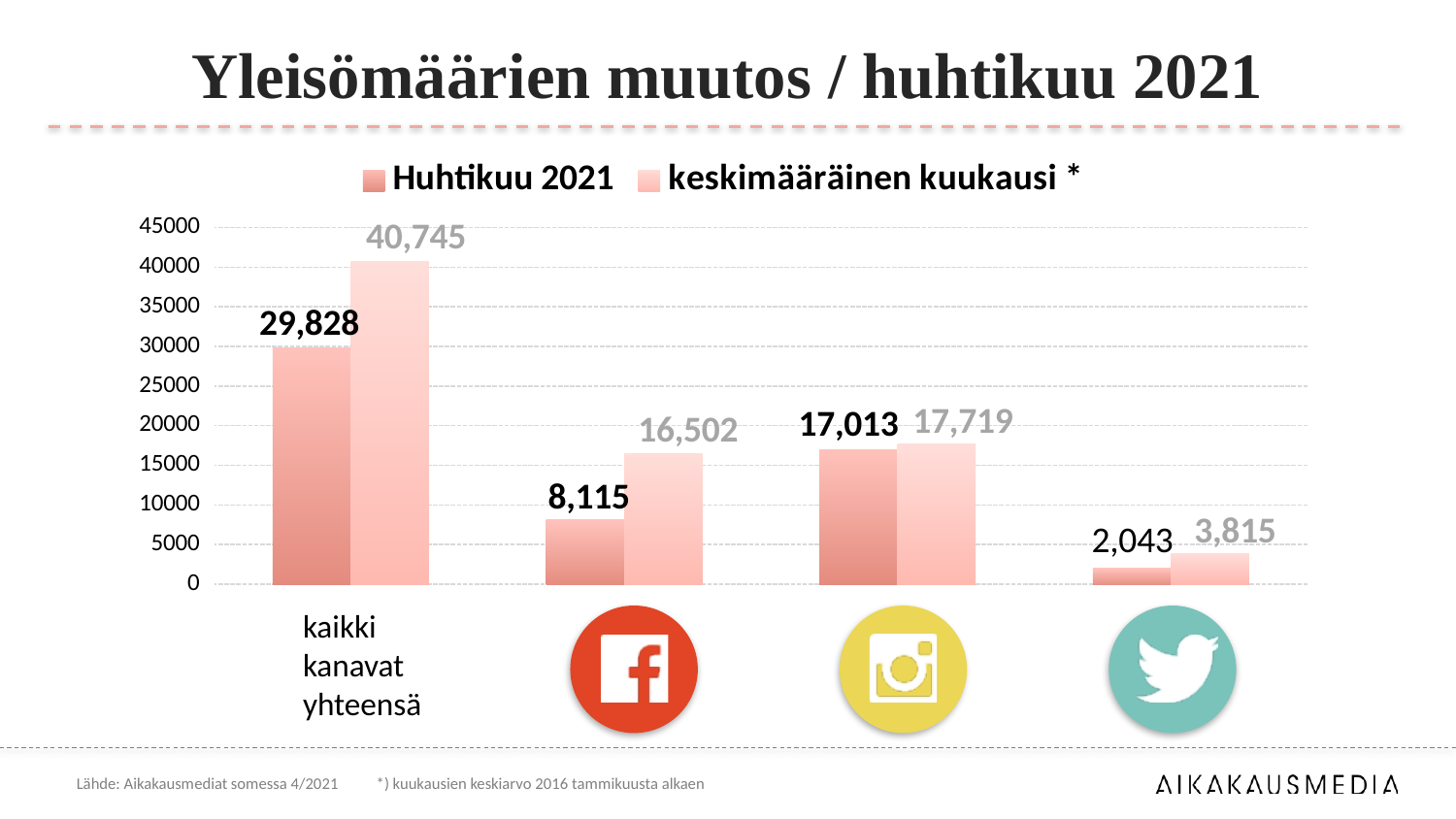
How many series does the legend list? 2 What is the Huhtikuu 2021 value for kaikki kanavat yhteensä? 29,828 What is the keskimääräinen kuukausi value for kaikki kanavat yhteensä? 40,745 What is the difference between the keskimääräinen kuukausi and Huhtikuu 2021 values for the Facebook category? 8,387 What is the difference between the keskimääräinen kuukausi and Huhtikuu 2021 values for kaikki kanavat yhteensä? 10,917 Which category has the lowest Huhtikuu 2021 value? Twitter What is the Huhtikuu 2021 value for the category marked with the Twitter icon? 2,043 How many categories are shown on the x axis? 4 What type of chart is shown on the slide? Bar chart What is the Huhtikuu 2021 value for the category marked with the Facebook icon? 8,115 What is the keskimääräinen kuukausi value for the category marked with the Instagram icon? 17,719 For the Instagram category, which is larger: the Huhtikuu 2021 value or the keskimääräinen kuukausi value? keskimääräinen kuukausi